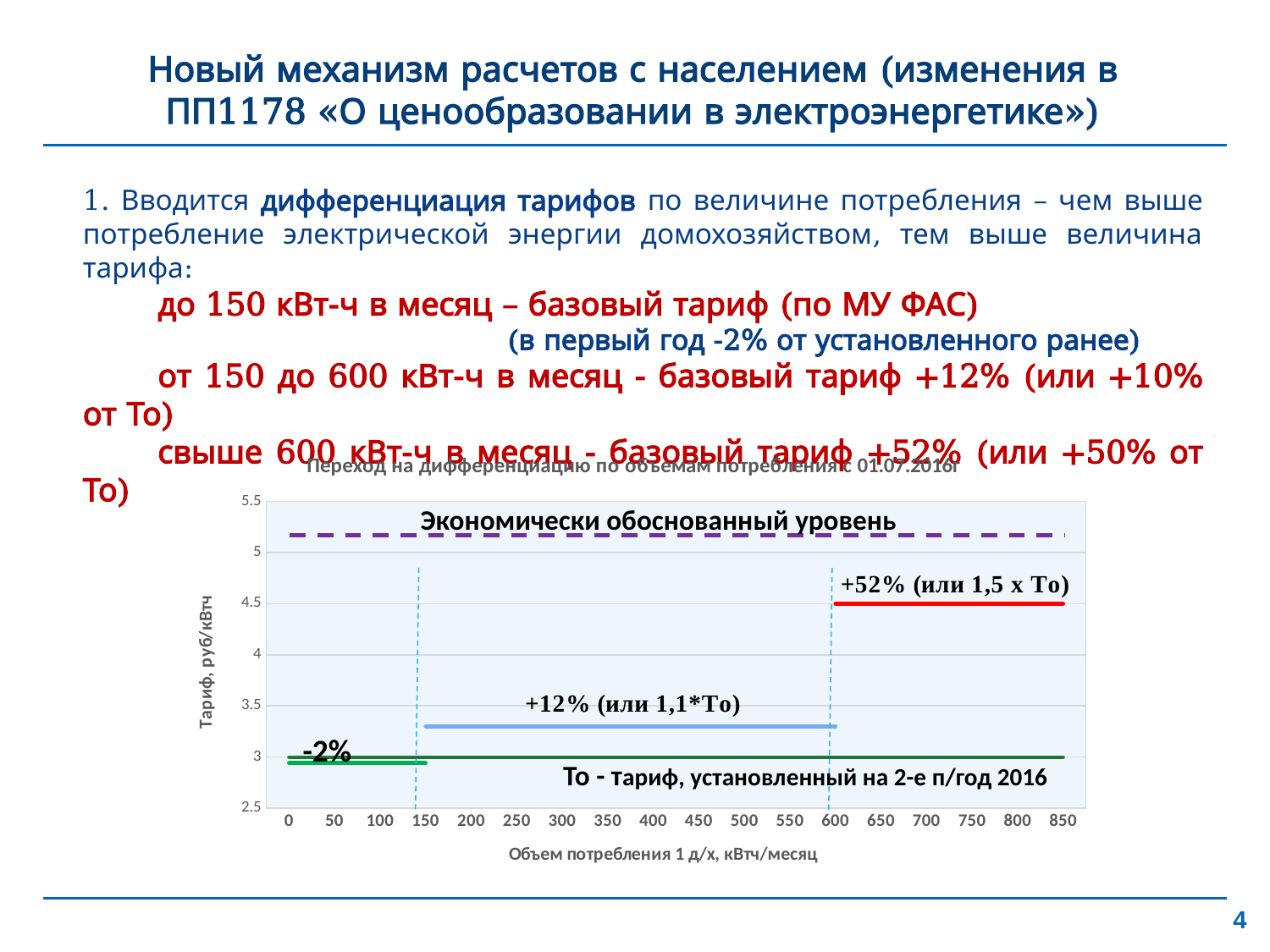
What is the label of the y axis of the chart? Тариф, руб/кВтч What is the highest value shown on the y axis of the chart? 5.5 Do the tariff levels of the stepped lines rise or fall as consumption volume increases along the x axis? rise Is the value of the red line (+52%) greater or less than 4? greater What kind of chart is shown on the slide? line chart Which line is lower on the chart: the green line (То) or the purple dashed line (Экономически обоснованный уровень)? the green line (То) Is the value of the blue line (+12%) greater or less than 3.5? less Which plotted line has the highest tariff level on the chart? Экономически обоснованный уровень What is the label of the x axis of the chart? Объем потребления 1 д/х, кВтч/месяц Which line is higher on the chart: the red line (+52%) or the blue line (+12%)? the red line (+52%) Is the value of the purple dashed line (Экономически обоснованный уровень) greater or less than 5? greater